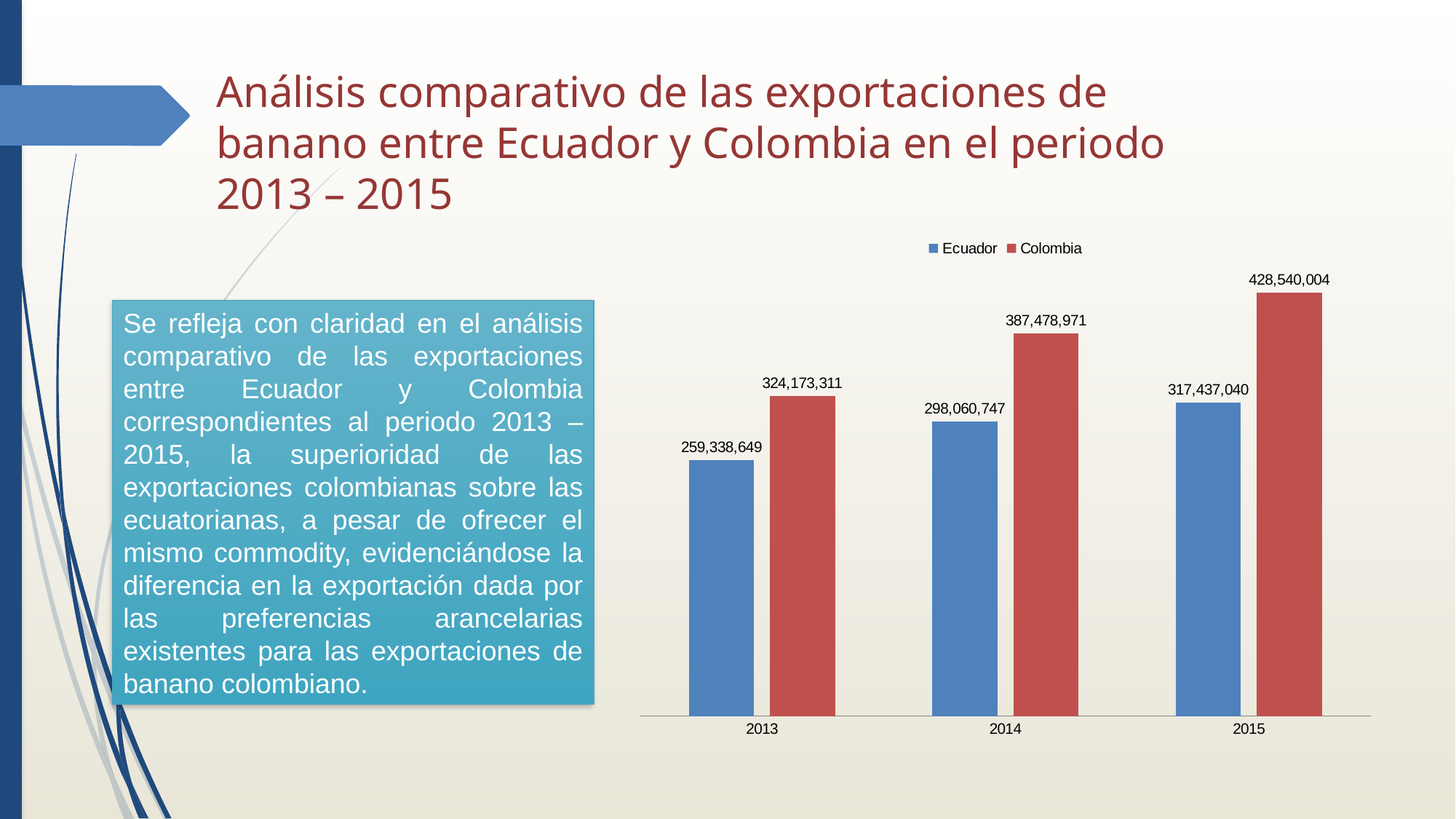
Which is larger in 2014, Ecuador or Colombia? Colombia What is the value for Ecuador in 2015? 317,437,040 What is the value for Colombia in 2014? 387,478,971 What kind of chart is shown on the slide? Bar chart What is the value for Colombia in 2015? 428,540,004 How many series does the legend list? 2 Which year has the lowest value for Ecuador? 2013 How many years are shown on the x axis? 3 What is the value for Ecuador in 2013? 259,338,649 What is the difference between Colombia and Ecuador in 2015? 111,102,964 What is the difference between Colombia and Ecuador in 2013? 64,834,662 Which year has the highest value for Colombia? 2015